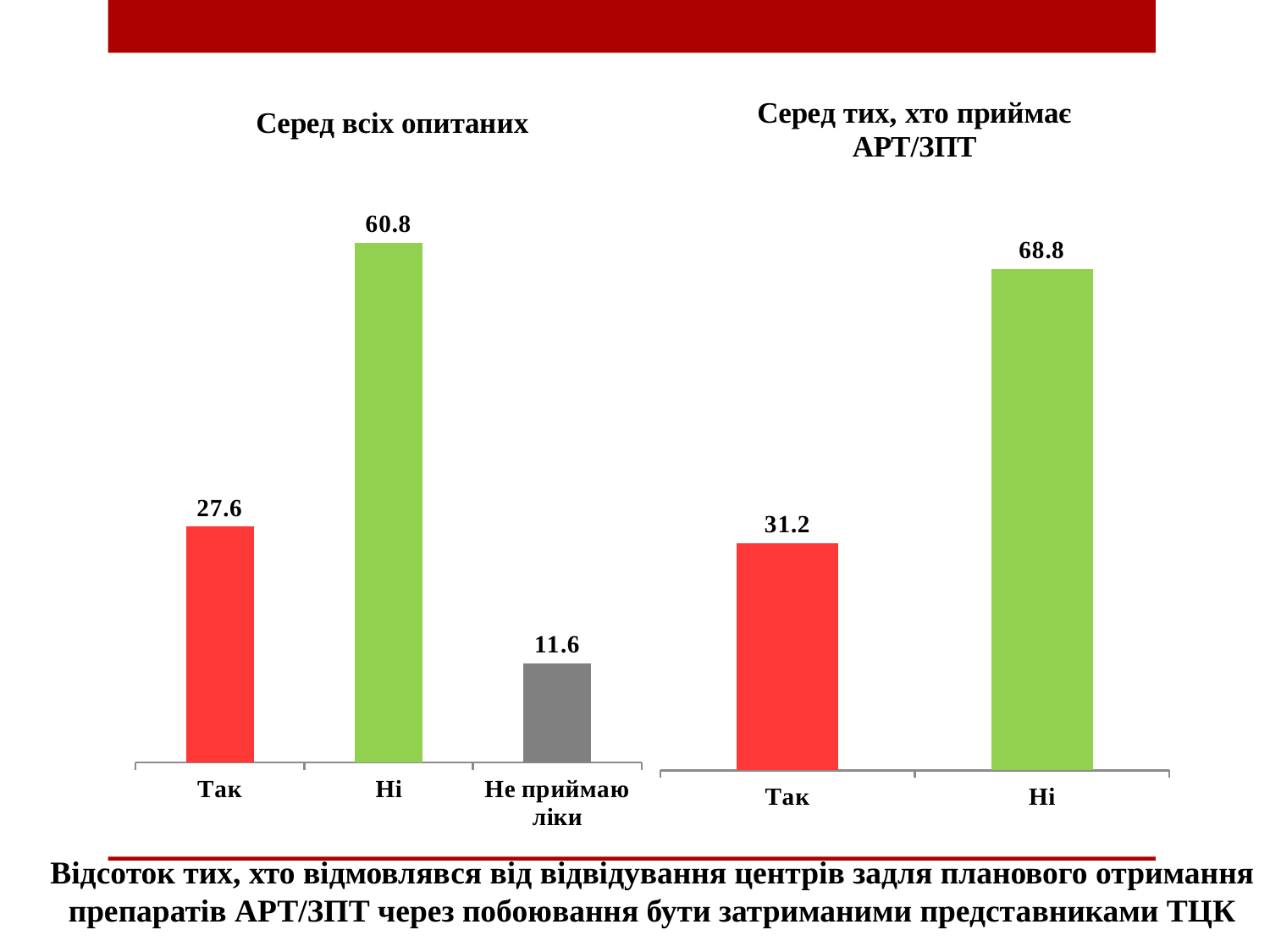
In the chart titled "Серед тих, хто приймає АРТ/ЗПТ", what is the difference between the values for "Ні" and "Так"? 37.6 In the chart titled "Серед всіх опитаних", what is the difference between the values for "Ні" and "Так"? 33.2 In the chart titled "Серед тих, хто приймає АРТ/ЗПТ", what is the value for "Ні"? 68.8 What type of chart is the chart titled "Серед тих, хто приймає АРТ/ЗПТ"? Bar chart In the chart titled "Серед тих, хто приймає АРТ/ЗПТ", which is larger, "Так" or "Ні"? Ні In the chart titled "Серед всіх опитаних", which category has the lowest value? Не приймаю ліки In the chart titled "Серед всіх опитаних", what is the value for "Не приймаю ліки"? 11.6 In the chart titled "Серед всіх опитаних", what is the value for "Ні"? 60.8 In the chart titled "Серед всіх опитаних", which category has the highest value? Ні How many categories are shown in the chart titled "Серед всіх опитаних"? 3 In the chart titled "Серед всіх опитаних", what is the value for "Так"? 27.6 In the chart titled "Серед тих, хто приймає АРТ/ЗПТ", what is the value for "Так"? 31.2